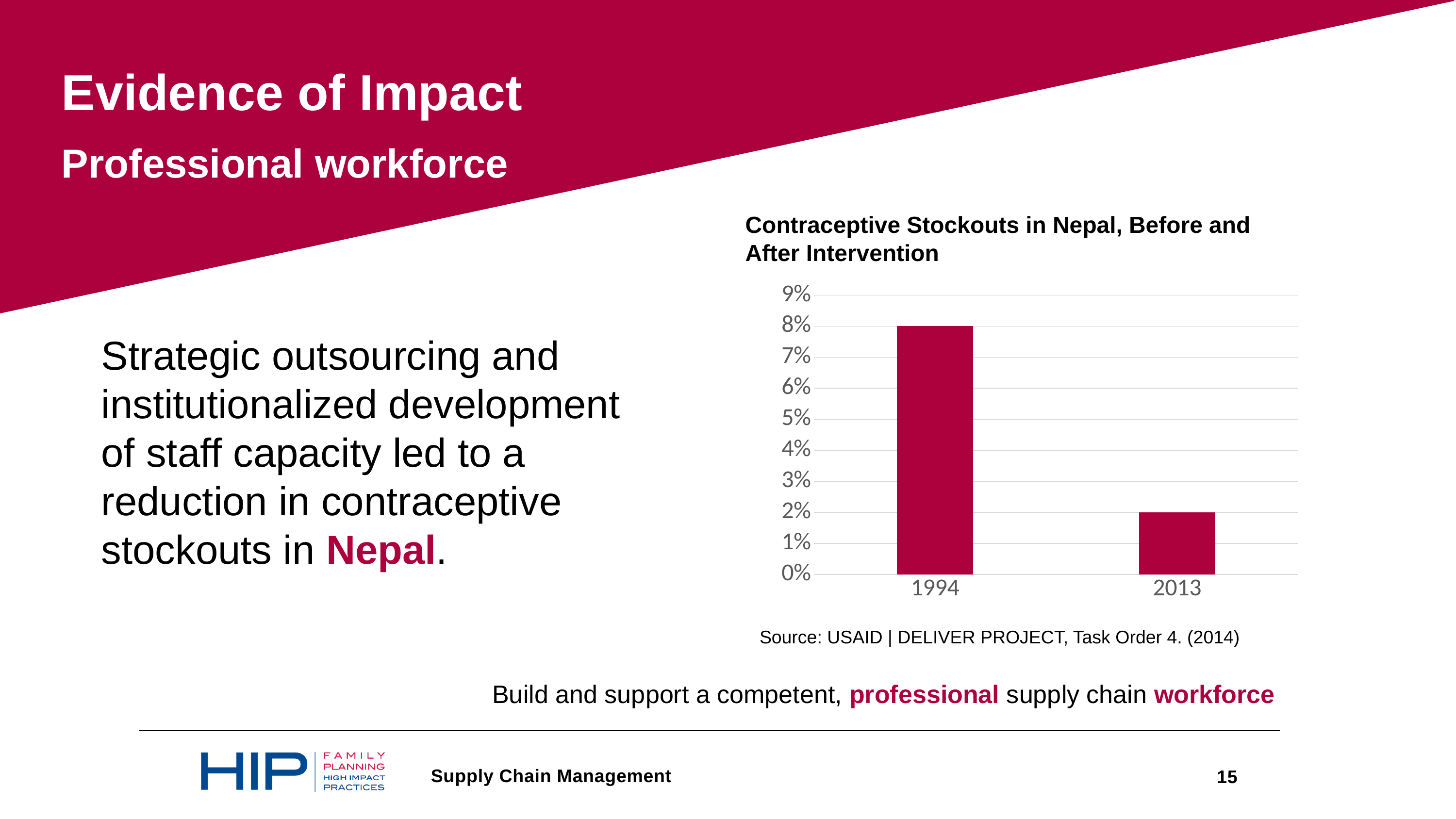
What is the title of the chart? Contraceptive Stockouts in Nepal, Before and After Intervention What is the contraceptive stockout value for 2013? 2% Which year has the higher stockout value? 1994 Is the value for 1994 greater or less than 5%? greater Which year has the lower stockout value? 2013 Is the value for 2013 greater or less than 4%? less Do the values rise or fall from 1994 to 2013? fall By how many percentage points did the stockout value fall from 1994 to 2013? 6% What is the highest value shown on the chart's vertical axis? 9% How many bars are plotted in the chart? 2 What is the contraceptive stockout value for 1994? 8% What type of chart is shown on the slide? bar chart